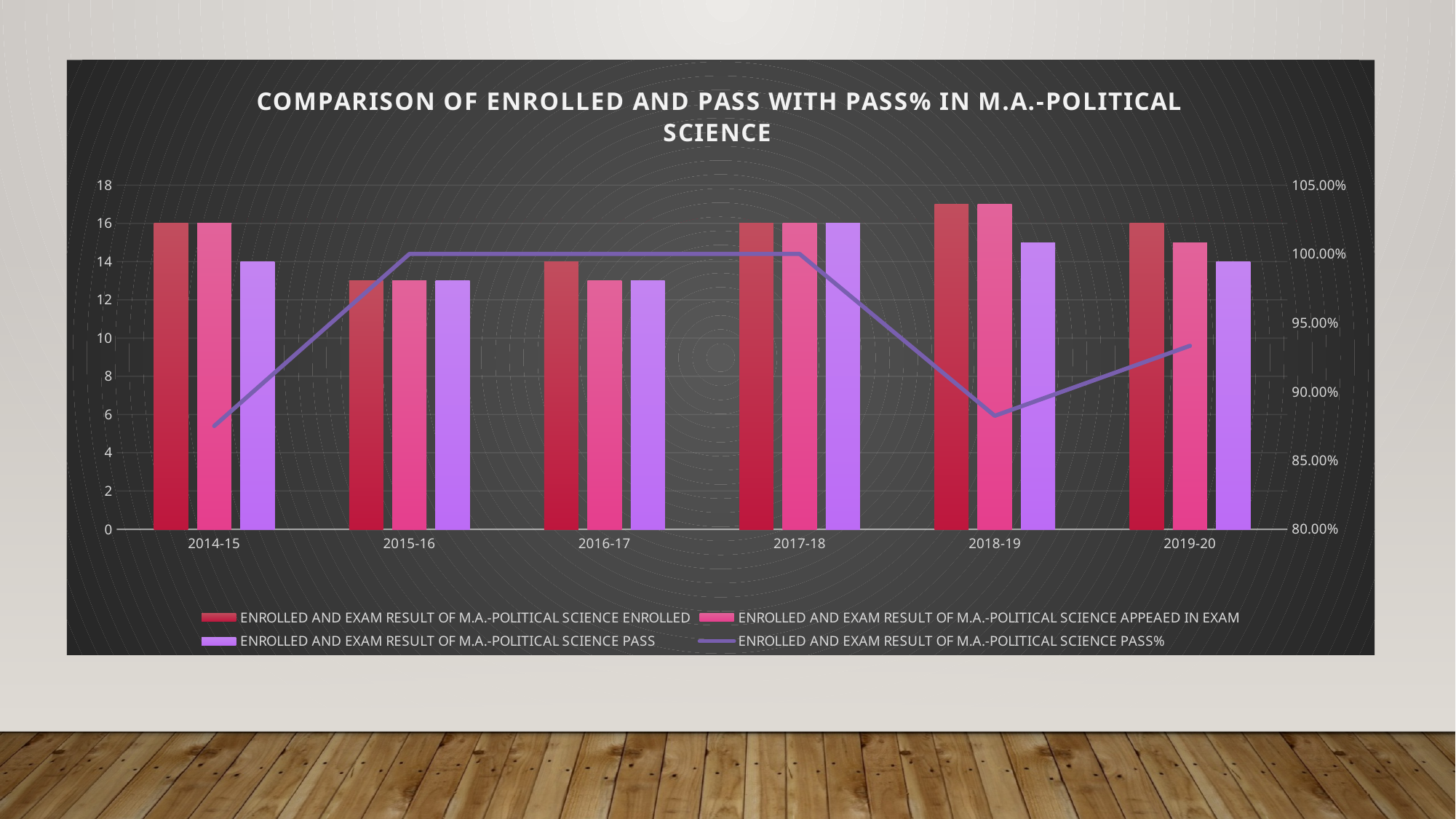
What is the Pass value for 2017-18? 16 How many academic years are shown on the x axis? 6 What is the Pass% value for 2016-17? 100.00% What is the difference between the Enrolled and Pass values for 2014-15? 2 How many series does the legend list? 4 What is the Pass value for 2014-15? 14 In which year is the Enrolled value lowest? 2015-16 In which year is the Enrolled value highest? 2018-19 Does the Pass% line rise or fall from 2017-18 to 2018-19? fall What type of chart is shown on the slide? Combination bar and line chart Is the Pass% value for 2019-20 greater or less than 90.00%? greater What is the Enrolled value for 2014-15? 16